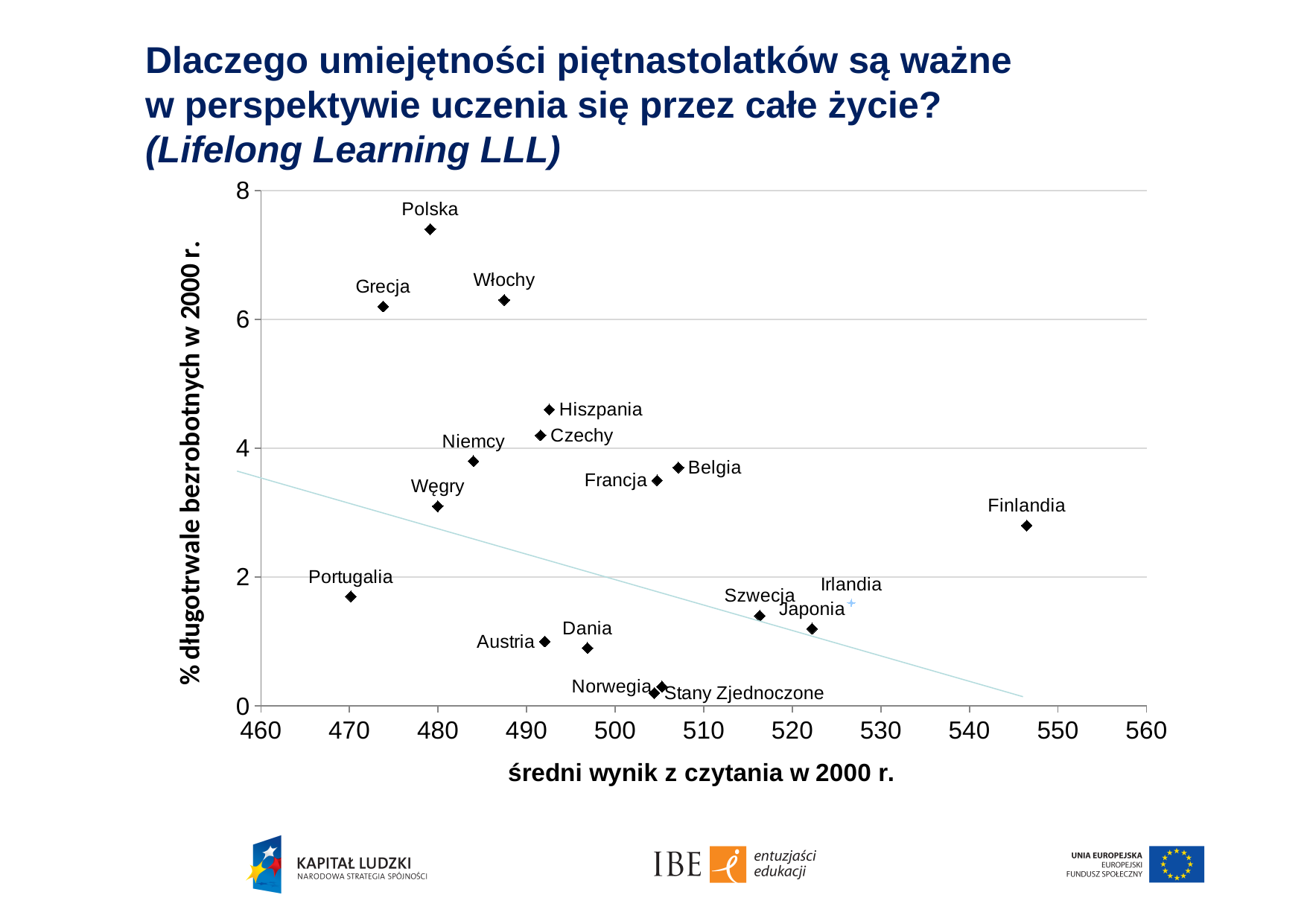
Is the percentage of long-term unemployed for Polska greater or less than 6? greater How many countries are plotted on the chart? 18 What kind of chart is shown on the slide? scatter chart Which country has the highest value on the vertical axis (% długotrwale bezrobotnych w 2000 r.)? Polska Does the trend line on the chart rise or fall as the average reading score increases? fall Which country has the lowest average reading score on the horizontal axis? Portugalia Is the average reading score for Finlandia greater or less than 540? greater Is the percentage of long-term unemployed for Portugalia greater or less than 2? less Which country has the highest average reading score (średni wynik z czytania w 2000 r.)? Finlandia What is the title of the horizontal axis? średni wynik z czytania w 2000 r. Which has a higher percentage of long-term unemployed, Belgia or Szwecja? Belgia